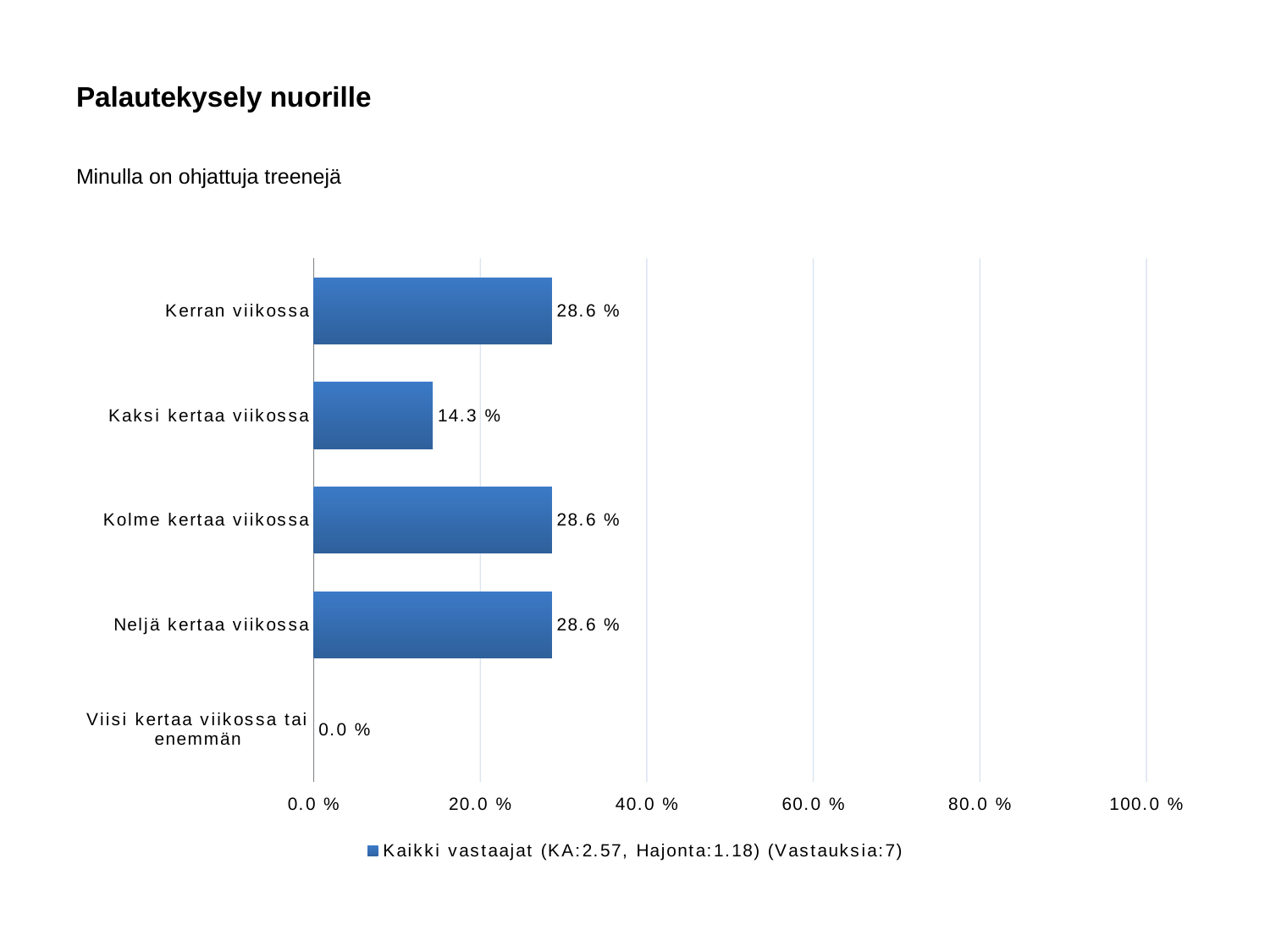
How many series does the legend list? 1 What is the value for "Kerran viikossa"? 28.6 % Which is larger, the value for "Neljä kertaa viikossa" or the value for "Kaksi kertaa viikossa"? Neljä kertaa viikossa What is the value for "Viisi kertaa viikossa tai enemmän"? 0.0 % How many categories are shown in the chart? 5 What is the value for "Kaksi kertaa viikossa"? 14.3 % Is the value for "Kolme kertaa viikossa" greater or less than 40.0 %? less What is the value for "Kolme kertaa viikossa"? 28.6 % What is the difference between the values for "Kerran viikossa" and "Kaksi kertaa viikossa"? 14.3 % What kind of chart is shown on the slide? bar chart What is the question text shown above the chart? Minulla on ohjattuja treenejä Which category has the lowest value? Viisi kertaa viikossa tai enemmän